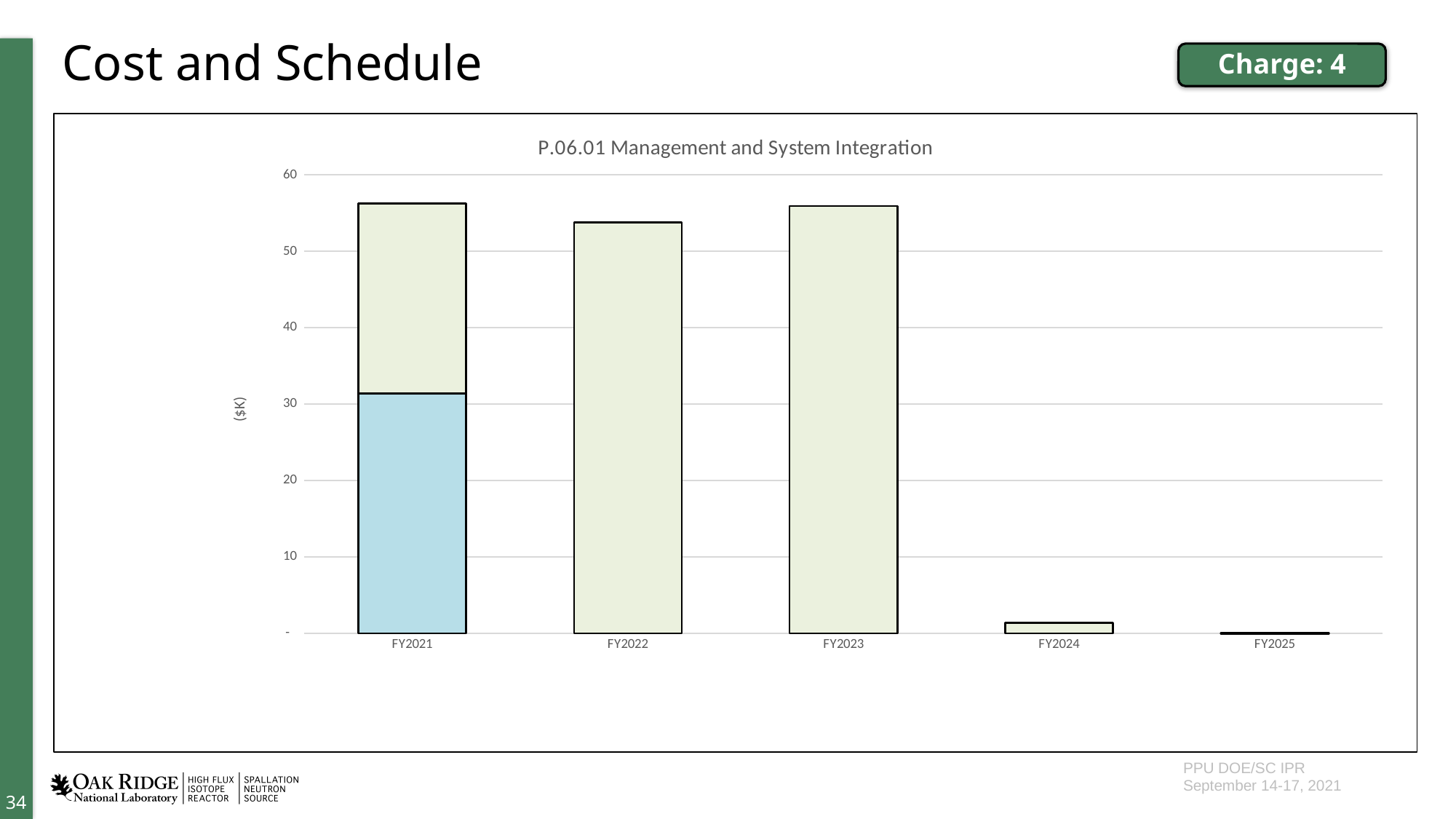
Is the value for FY2022 greater or less than 50? greater Is the value for FY2023 greater or less than 40? greater What kind of chart is shown on the slide? bar chart How many fiscal year categories are shown on the x axis? 5 What is the title of the chart? P.06.01 Management and System Integration Do the values generally rise or fall from FY2021 to FY2025? fall Which is larger, the value for FY2023 or the value for FY2025? FY2023 Which is larger, the value for FY2022 or the value for FY2024? FY2022 What is the label on the vertical axis? ($K) Which fiscal year has the lowest value? FY2025 Is the total value for FY2021 greater or less than 50? greater